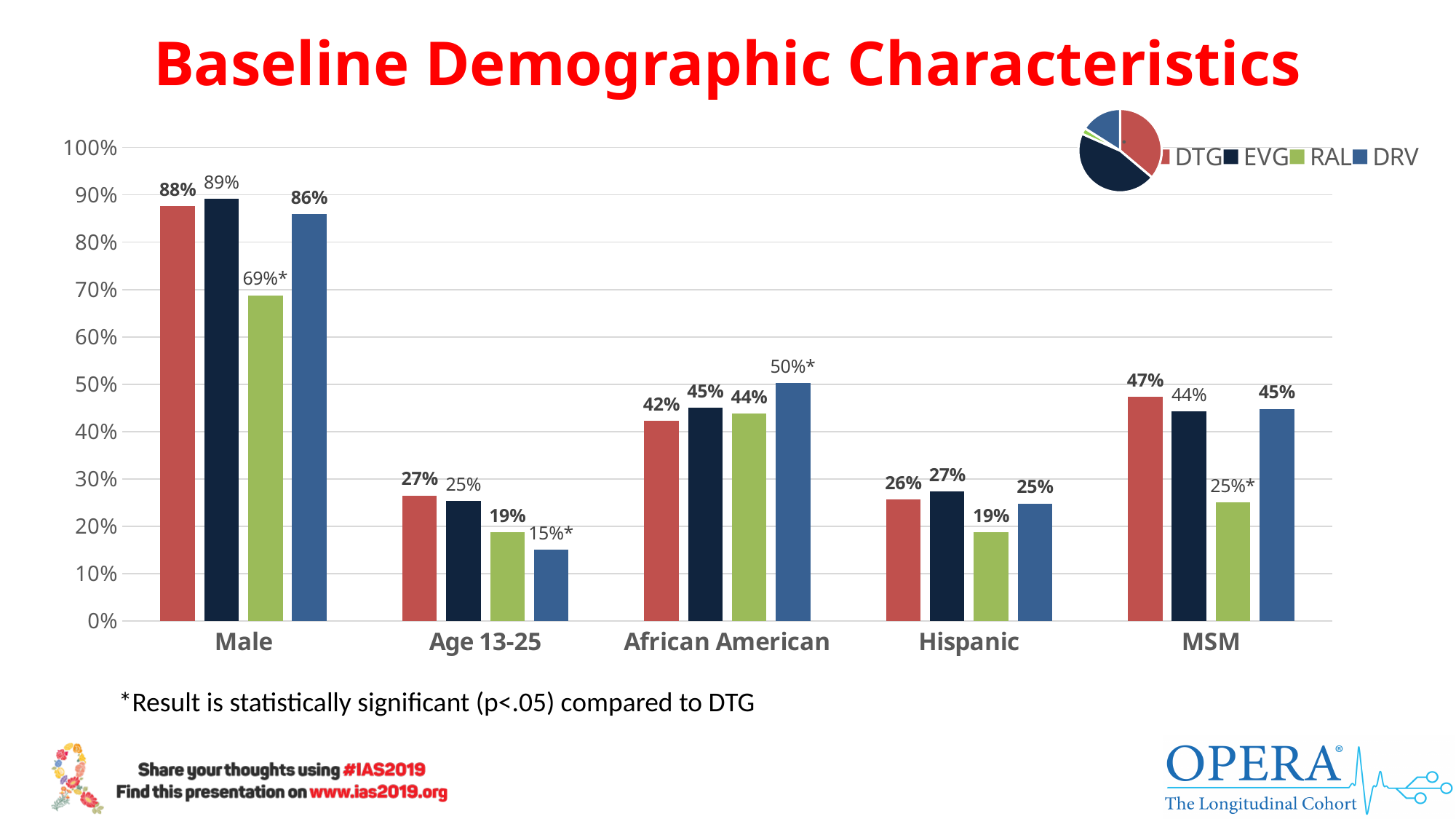
How many series does the legend list? 4 What is the value for DRV in the African American category? 50% What is the value for RAL in the Age 13-25 category? 19% Which is larger in the Hispanic category, the value for EVG or the value for RAL? EVG Is the value for DRV in the Male category greater or less than 80%? greater What is the title of the slide? Baseline Demographic Characteristics What kind of chart is the main chart on the slide? bar chart How many categories are shown on the x axis of the bar chart? 5 Which series has the lowest value in the Age 13-25 category? DRV Which series has the highest value in the MSM category? DTG What is the difference between the DTG and RAL values in the Male category? 19% What is the value for DTG in the Male category? 88%